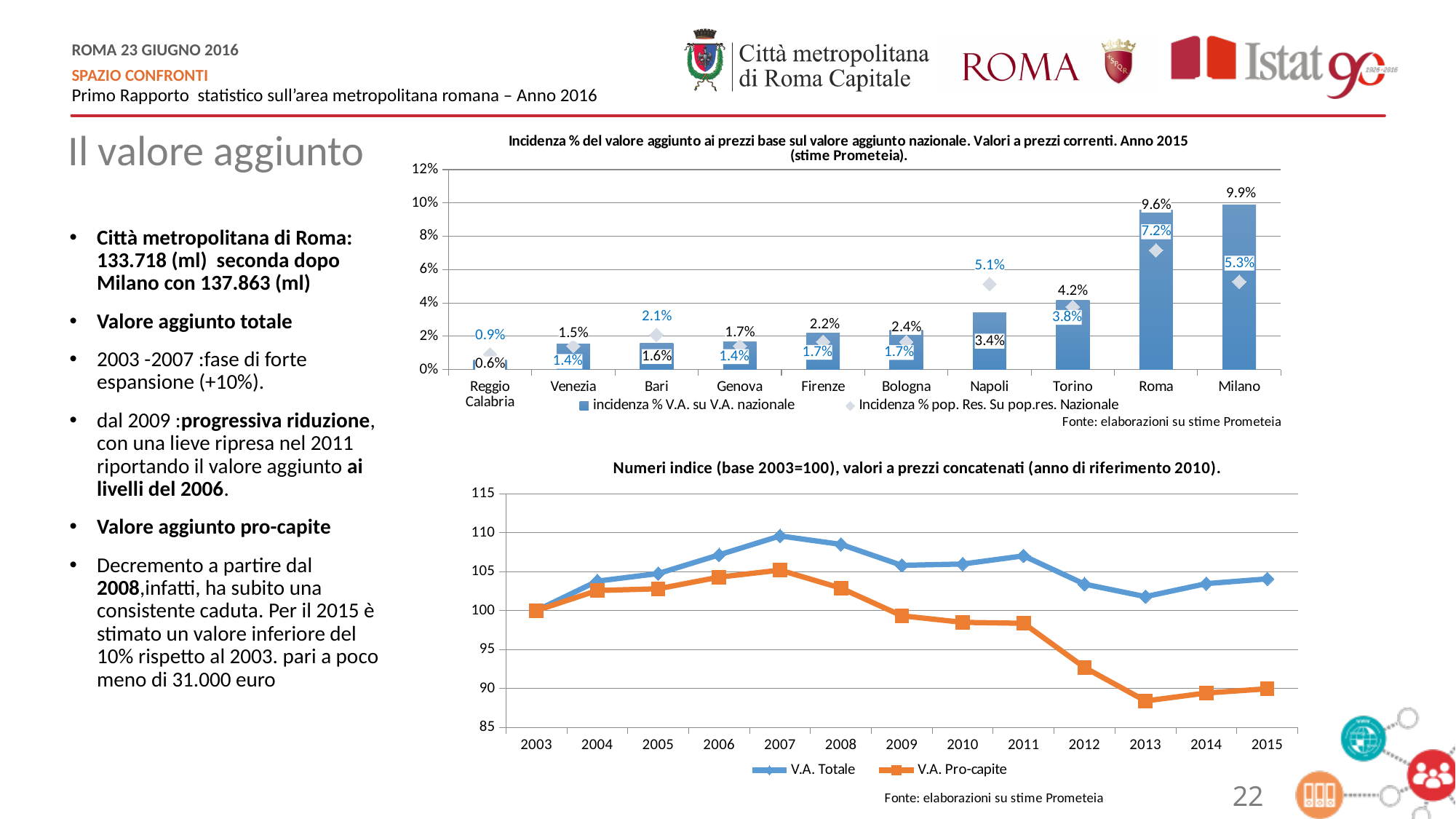
What kind of chart is the bottom chart? Line chart In the top chart, which is larger for Torino: the incidenza % V.A. su V.A. nazionale or the Incidenza % pop. Res. su pop. res. Nazionale? incidenza % V.A. su V.A. nazionale How many series does the legend of the bottom chart list? 2 How many cities are shown in the top chart? 10 In the bottom chart, is the value of V.A. Totale in 2007 greater or less than 105? greater In the top chart, which city has the highest incidenza % V.A. su V.A. nazionale? Milano In the top chart, what is the difference between the incidenza % V.A. su V.A. nazionale for Milano and for Roma? 0.3% In the top chart, what is the Incidenza % pop. Res. su pop. res. Nazionale for Napoli? 5.1% In the top chart, what is the incidenza % V.A. su V.A. nazionale for Milano? 9.9% In the bottom chart, does the V.A. Pro-capite series rise or fall from 2011 to 2013? fall In the bottom chart, is the value of V.A. Pro-capite in 2013 greater or less than 90? less In the top chart, which city has the lowest incidenza % V.A. su V.A. nazionale? Reggio Calabria